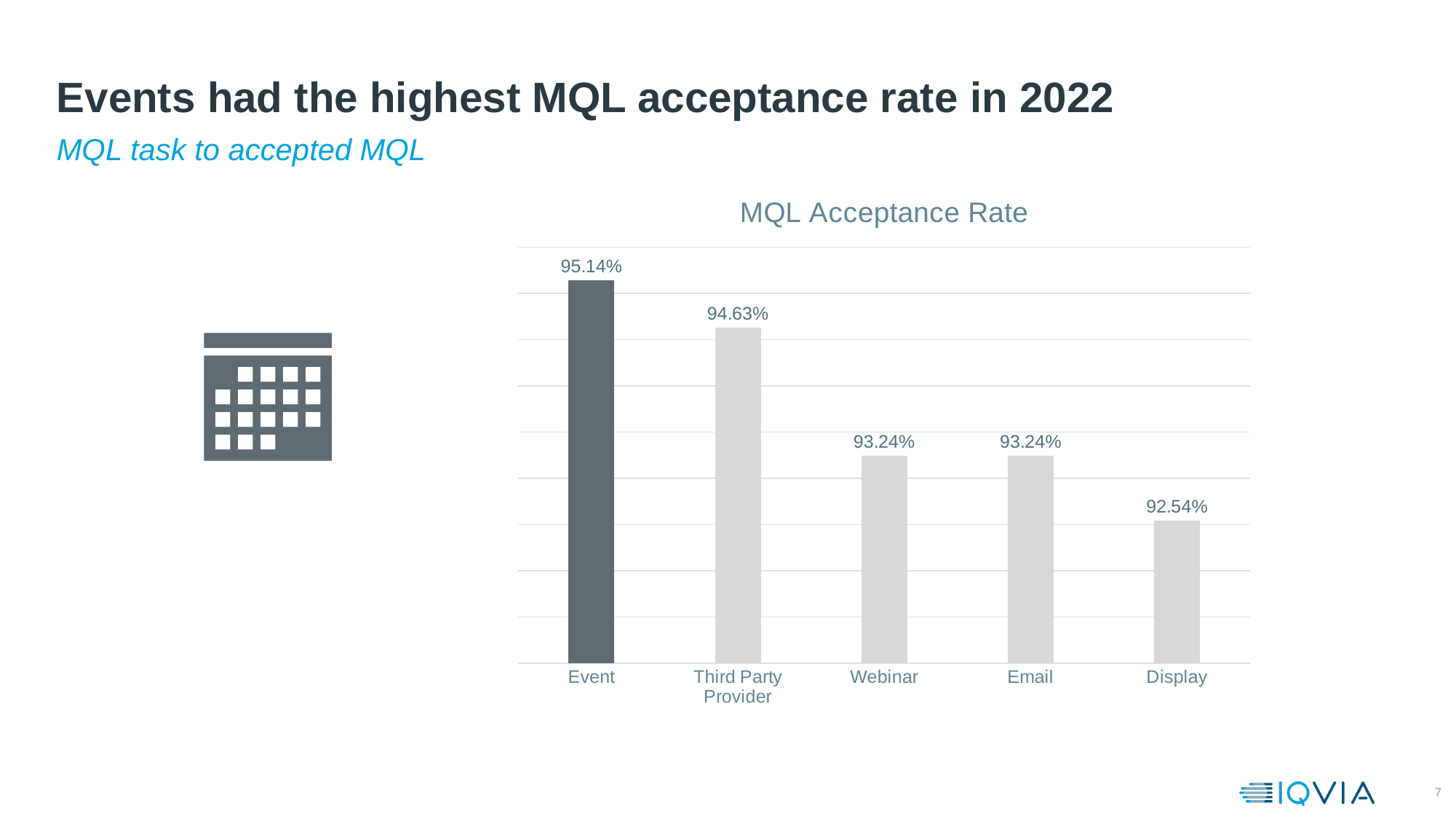
What is the MQL acceptance rate for Display? 92.54% Which category has the lowest MQL acceptance rate? Display What is the MQL acceptance rate for Event? 95.14% What is the difference in MQL acceptance rate between Event and Display? 2.60% Which category has the highest MQL acceptance rate? Event What is the MQL acceptance rate for Webinar? 93.24% What kind of chart is shown on the slide? Bar chart Which has a higher MQL acceptance rate, Third Party Provider or Webinar? Third Party Provider What is the MQL acceptance rate for Third Party Provider? 94.63% What is the title of the chart? MQL Acceptance Rate How many categories are shown in the chart? 5 What is the difference in MQL acceptance rate between Third Party Provider and Email? 1.39%